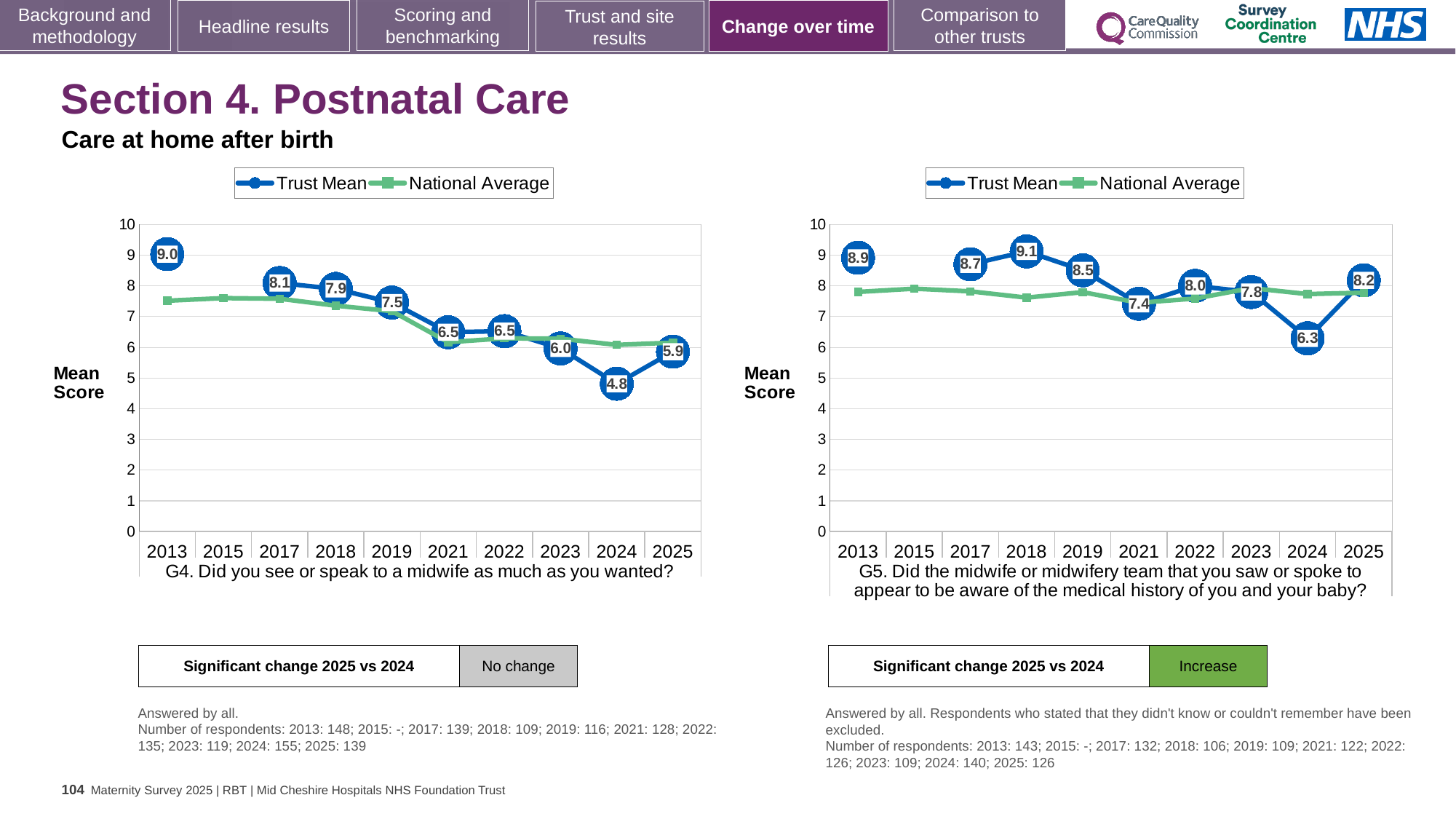
In the G5 chart (right), what is the Trust Mean for 2018? 9.1 In the G5 chart (right), which year has the highest Trust Mean? 2018 What kind of chart is the G4 chart (left)? line chart In the G4 chart (left), what is the Trust Mean for 2013? 9.0 In the G4 chart (left), does the Trust Mean generally rise or fall from 2013 to 2025? fall In the G4 chart (left), which year has the lowest Trust Mean? 2024 In the G4 chart (left), is the National Average for 2013 greater or less than 8? less In the G5 chart (right), what is the difference between the Trust Mean in 2025 and in 2024? 1.9 In the G5 chart (right), which is larger, the Trust Mean for 2021 or for 2022? 2022 How many series does the legend of the G5 chart (right) list? 2 In the G4 chart (left), what is the difference between the Trust Mean in 2025 and in 2024? 1.1 In the G4 chart (left), what is the Trust Mean for 2024? 4.8